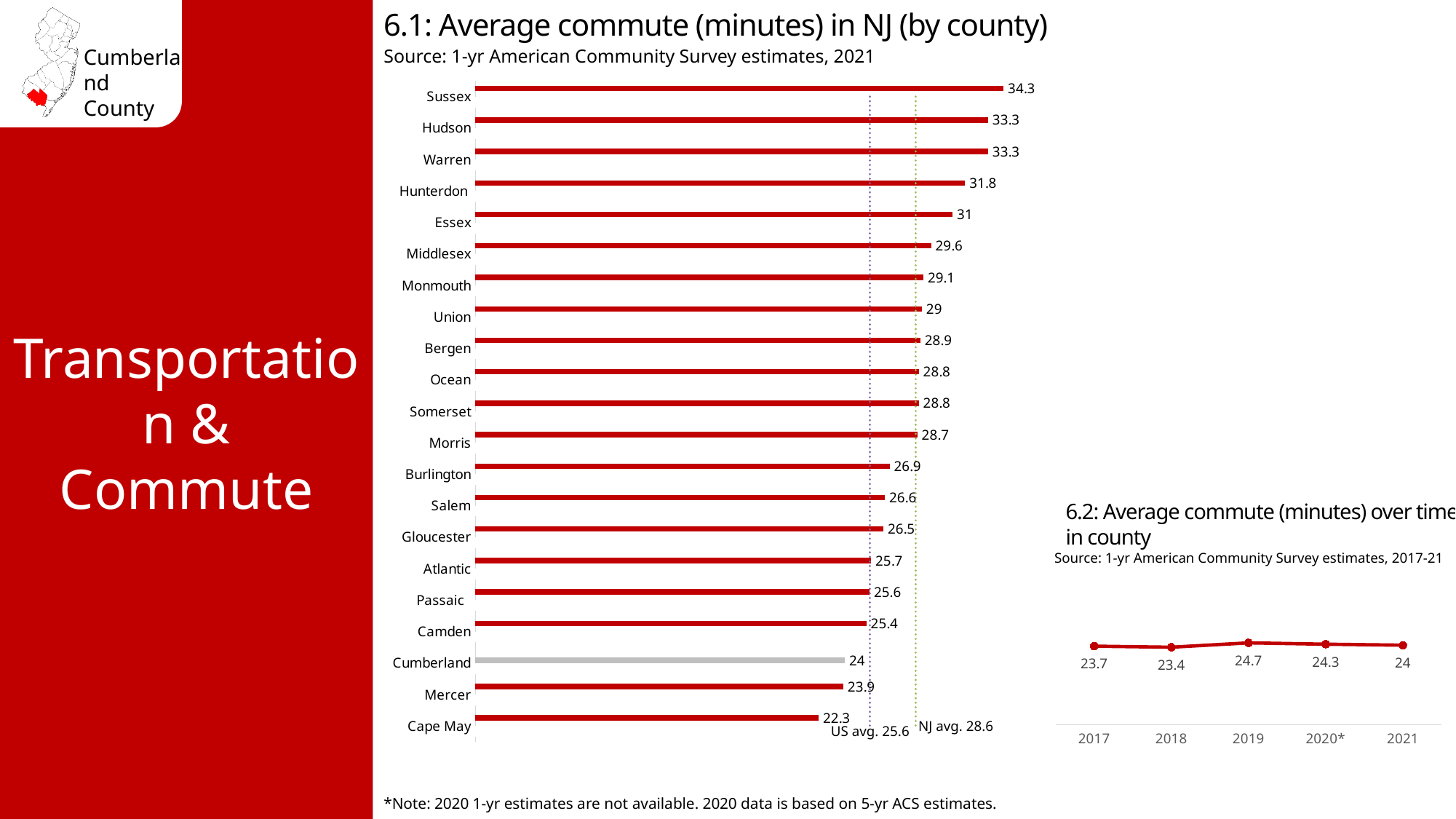
In chart 6.1 (Average commute in NJ by county), how many counties are shown? 21 In chart 6.1 (Average commute in NJ by county), which county has the lowest average commute? Cape May In chart 6.1 (Average commute in NJ by county), what is the average commute for Cumberland? 24 In chart 6.1 (Average commute in NJ by county), what is the difference between Sussex and Cape May? 12 In chart 6.1 (Average commute in NJ by county), what is the US average shown by the reference line? 25.6 In chart 6.2 (Average commute over time in county), what is the value for 2019? 24.7 What kind of chart is chart 6.2 (Average commute over time in county)? line chart In chart 6.2 (Average commute over time in county), which year has the lowest value? 2018 In chart 6.1 (Average commute in NJ by county), which county has the highest average commute? Sussex In chart 6.1 (Average commute in NJ by county), which has a longer average commute, Essex or Middlesex? Essex In chart 6.1 (Average commute in NJ by county), what is the NJ average shown by the reference line? 28.6 What kind of chart is chart 6.1 (Average commute in NJ by county)? bar chart